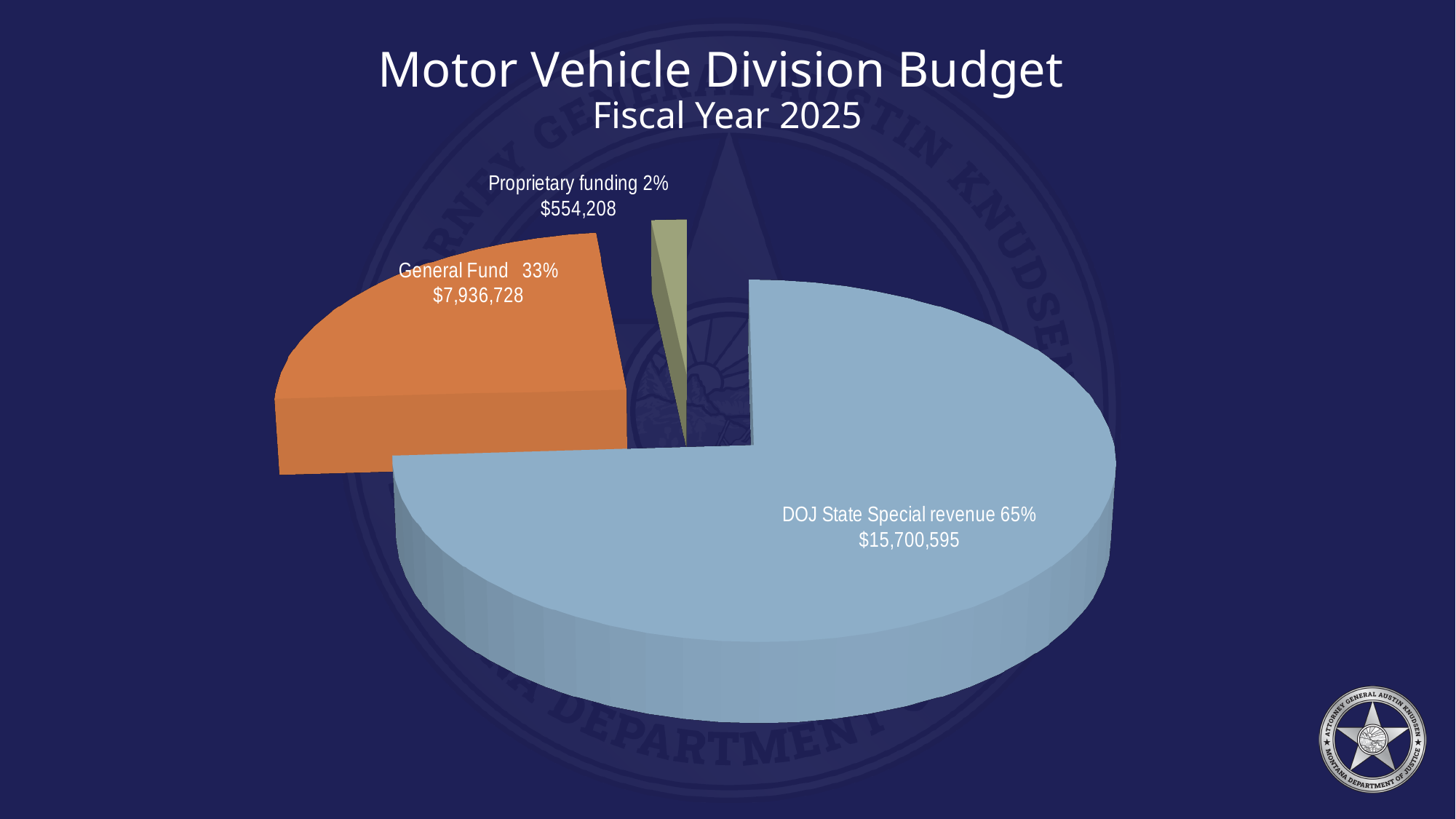
Which is larger, General Fund or Proprietary funding? General Fund What kind of chart is shown on the slide? Pie chart Which funding source is the smallest? Proprietary funding How many slices does the pie chart have? 3 What is the dollar value for DOJ State Special revenue? $15,700,595 What is the dollar value for General Fund? $7,936,728 What share of the pie does Proprietary funding represent? 2% What share of the pie does General Fund represent? 33% Which funding source is the largest? DOJ State Special revenue What is the dollar value for Proprietary funding? $554,208 What share of the pie does DOJ State Special revenue represent? 65% What is the difference in dollars between DOJ State Special revenue and General Fund? $7,763,867